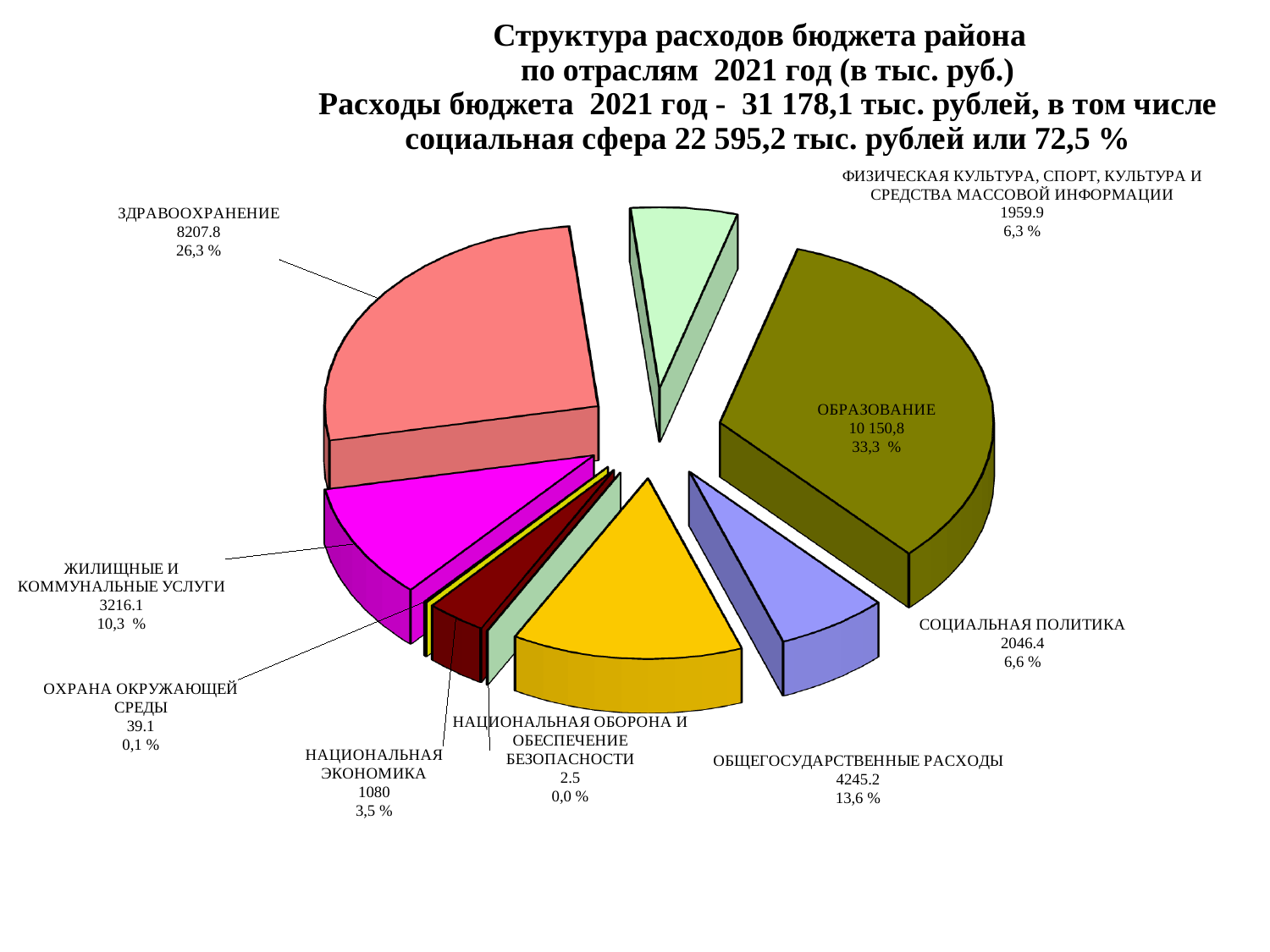
Which category has the largest slice of the pie? ОБРАЗОВАНИЕ What kind of chart is shown on the slide? pie chart Which is larger, the value for СОЦИАЛЬНАЯ ПОЛИТИКА or the value for ФИЗИЧЕСКАЯ КУЛЬТУРА, СПОРТ, КУЛЬТУРА И СРЕДСТВА МАССОВОЙ ИНФОРМАЦИИ? СОЦИАЛЬНАЯ ПОЛИТИКА Which category has the smallest slice of the pie? НАЦИОНАЛЬНАЯ ОБОРОНА И ОБЕСПЕЧЕНИЕ БЕЗОПАСНОСТИ What share of the pie does СОЦИАЛЬНАЯ ПОЛИТИКА represent? 6,6 % What is the value for ОБЩЕГОСУДАРСТВЕННЫЕ РАСХОДЫ? 4245.2 What is the difference between the values for ОБЩЕГОСУДАРСТВЕННЫЕ РАСХОДЫ and ЖИЛИЩНЫЕ И КОММУНАЛЬНЫЕ УСЛУГИ? 1029.1 According to the chart title, what is the total budget expenditure for 2021? 31 178,1 тыс. рублей What share of the pie does ЖИЛИЩНЫЕ И КОММУНАЛЬНЫЕ УСЛУГИ represent? 10,3 % How many categories (slices) does the pie chart show? 9 What is the value for ОБРАЗОВАНИЕ? 10 150,8 What is the value for ЗДРАВООХРАНЕНИЕ? 8207.8